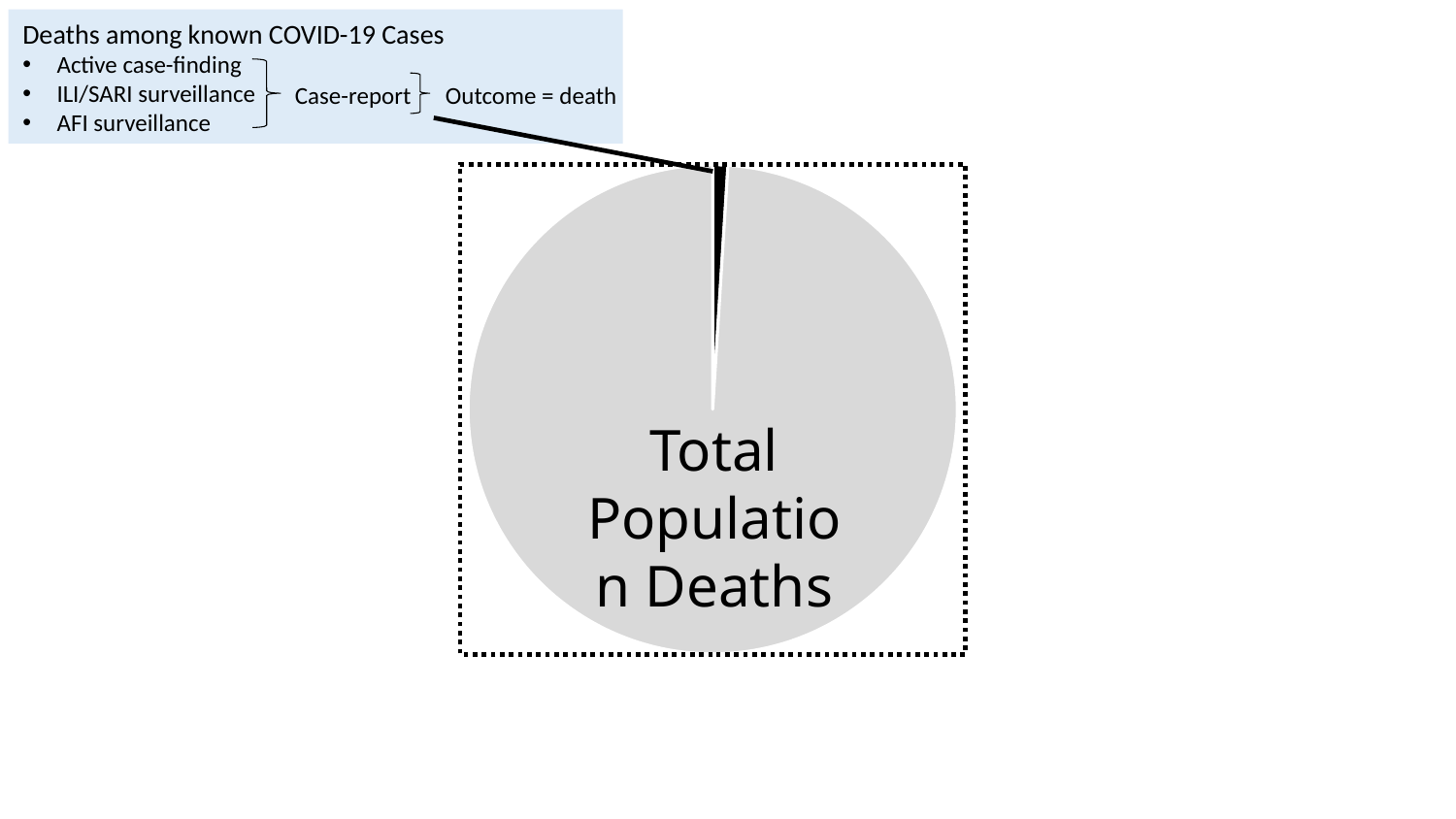
What label is printed inside the large slice of the pie chart? Total Population Deaths What colour is the large slice of the pie chart? grey Which is larger in the pie chart: the Total Population Deaths slice or the Deaths among known COVID-19 Cases slice? Total Population Deaths Which slice of the pie chart is the largest? Total Population Deaths What kind of chart is shown on the slide? pie chart Which slice of the pie chart is the smallest? Deaths among known COVID-19 Cases How many slices does the pie chart have? 2